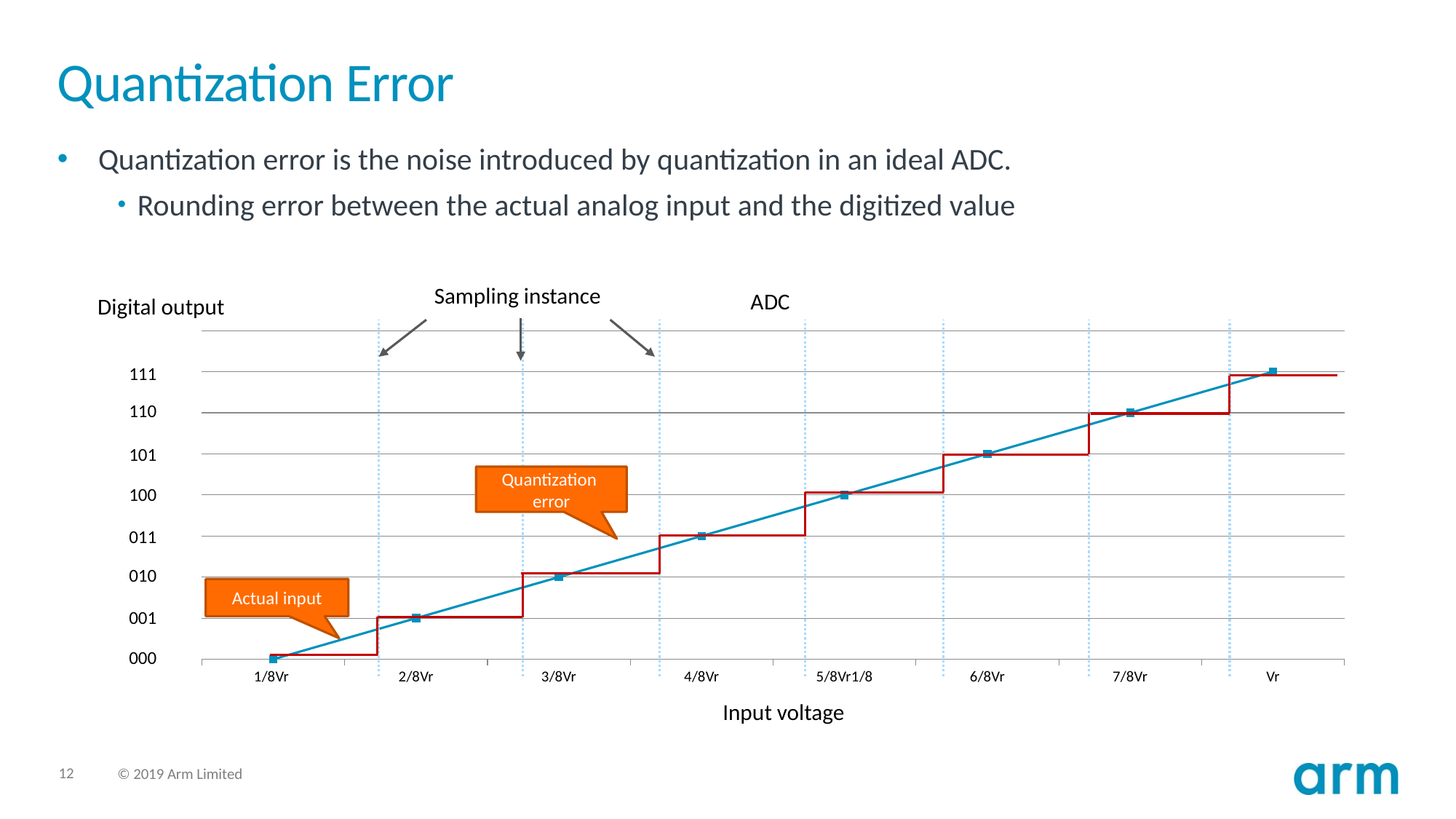
How many input voltage categories are shown on the x axis? 8 What digital output does the blue line reach at an input voltage of 7/8Vr? 110 At which input voltage is the digital output highest? Vr What digital output does the blue line reach at an input voltage of Vr? 111 Does the digital output rise or fall as the input voltage increases along the x axis? rise What is the label of the x axis of the chart? Input voltage What digital output does the blue line reach at an input voltage of 2/8Vr? 001 What is the title of the chart? ADC What kind of chart is shown on the slide? line chart At which input voltage is the digital output lowest? 1/8Vr Which is larger, the digital output at 6/8Vr or at 3/8Vr? 6/8Vr What digital output does the blue line reach at an input voltage of 4/8Vr? 011